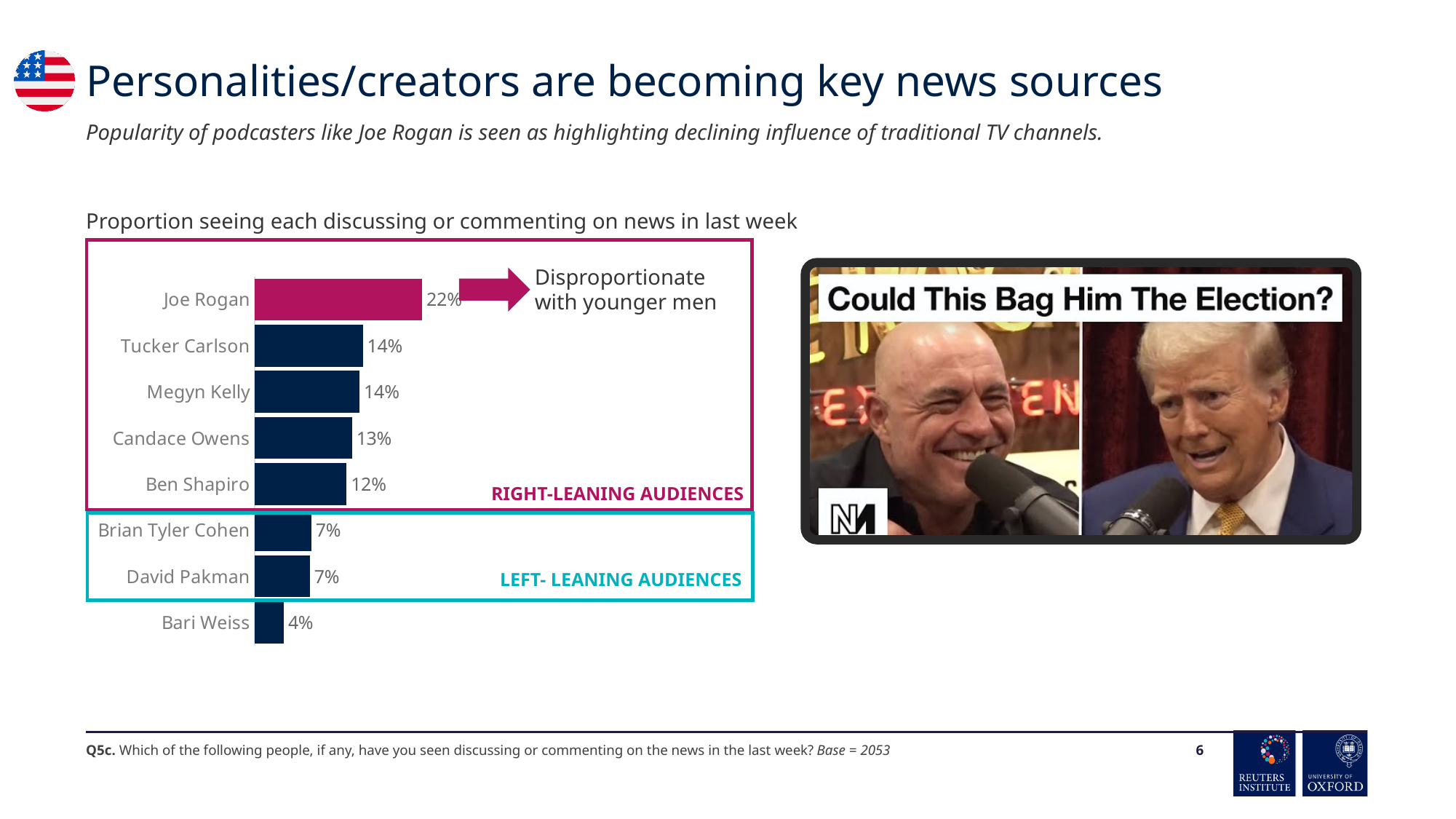
What is the value shown for Candace Owens? 13% What is the value shown for Ben Shapiro? 12% What is the value shown for Bari Weiss? 4% What is the difference between the values for Joe Rogan and Tucker Carlson? 8% What is the difference between the values for Ben Shapiro and David Pakman? 5% What proportion saw Joe Rogan discussing or commenting on news in the last week? 22% Which person has the highest proportion in the chart? Joe Rogan What kind of chart is shown on the slide? Bar chart Which person has the lowest proportion in the chart? Bari Weiss Which two people are grouped under the 'LEFT- LEANING AUDIENCES' box? Brian Tyler Cohen and David Pakman How many people are listed in the chart? 8 Which is larger, the value for Megyn Kelly or the value for Brian Tyler Cohen? Megyn Kelly